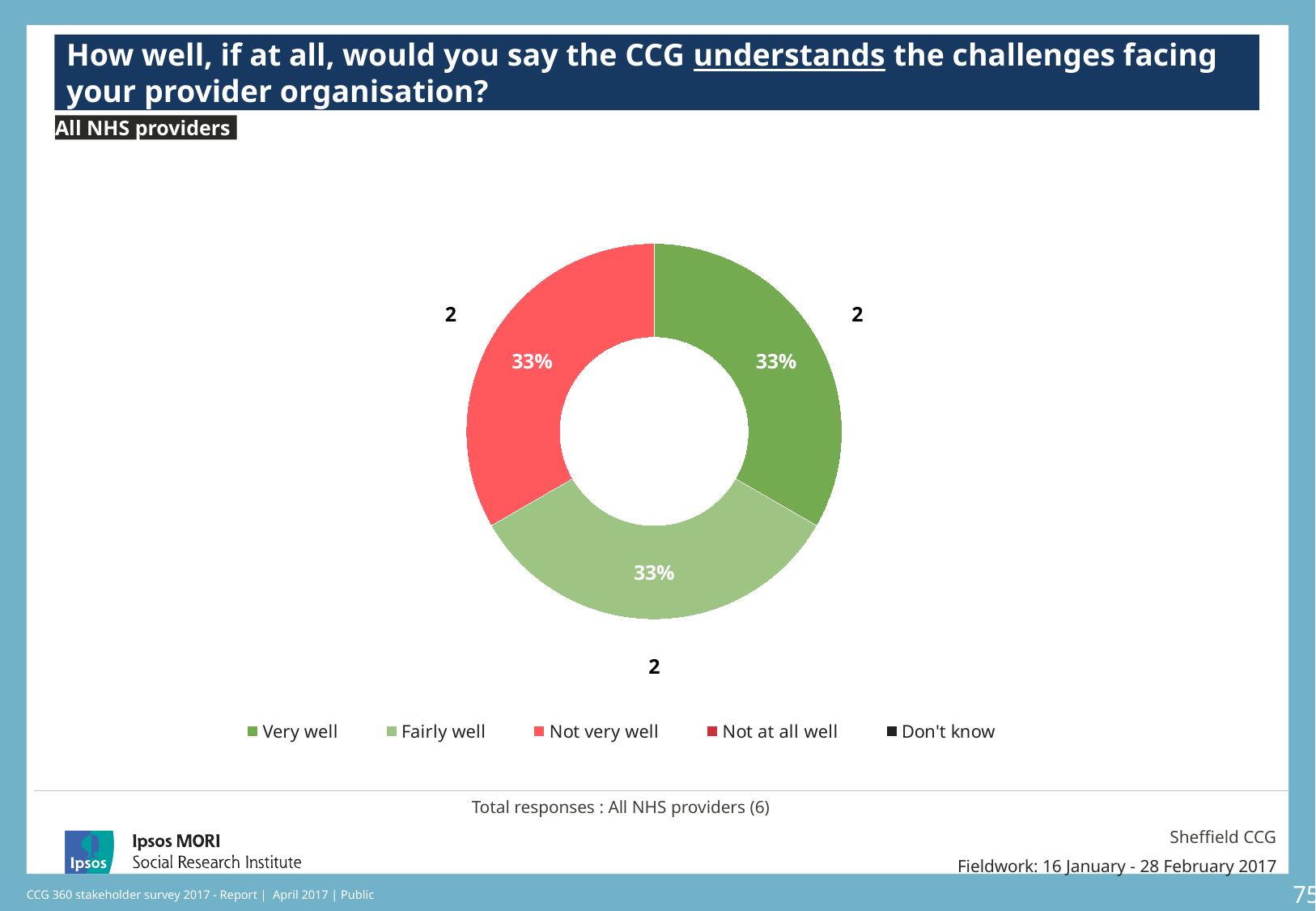
What share of the pie does the 'Fairly well' slice represent? 33% What percentage of respondents answered 'Fairly well'? 33% How many slices are shown in the chart? 3 How many response categories does the legend list? 5 What percentage of respondents answered 'Not very well'? 33% How many respondents answered 'Very well'? 2 How many respondents answered 'Not very well'? 2 What is the total number of responses shown for All NHS providers? 6 What is the difference in percentage points between the 'Very well' and 'Not very well' slices? 0 What percentage of respondents said the CCG understands the challenges facing their provider organisation 'Very well'? 33% Which colour represents 'Not very well' in the legend? Red What kind of chart is shown on the slide? Pie (donut) chart